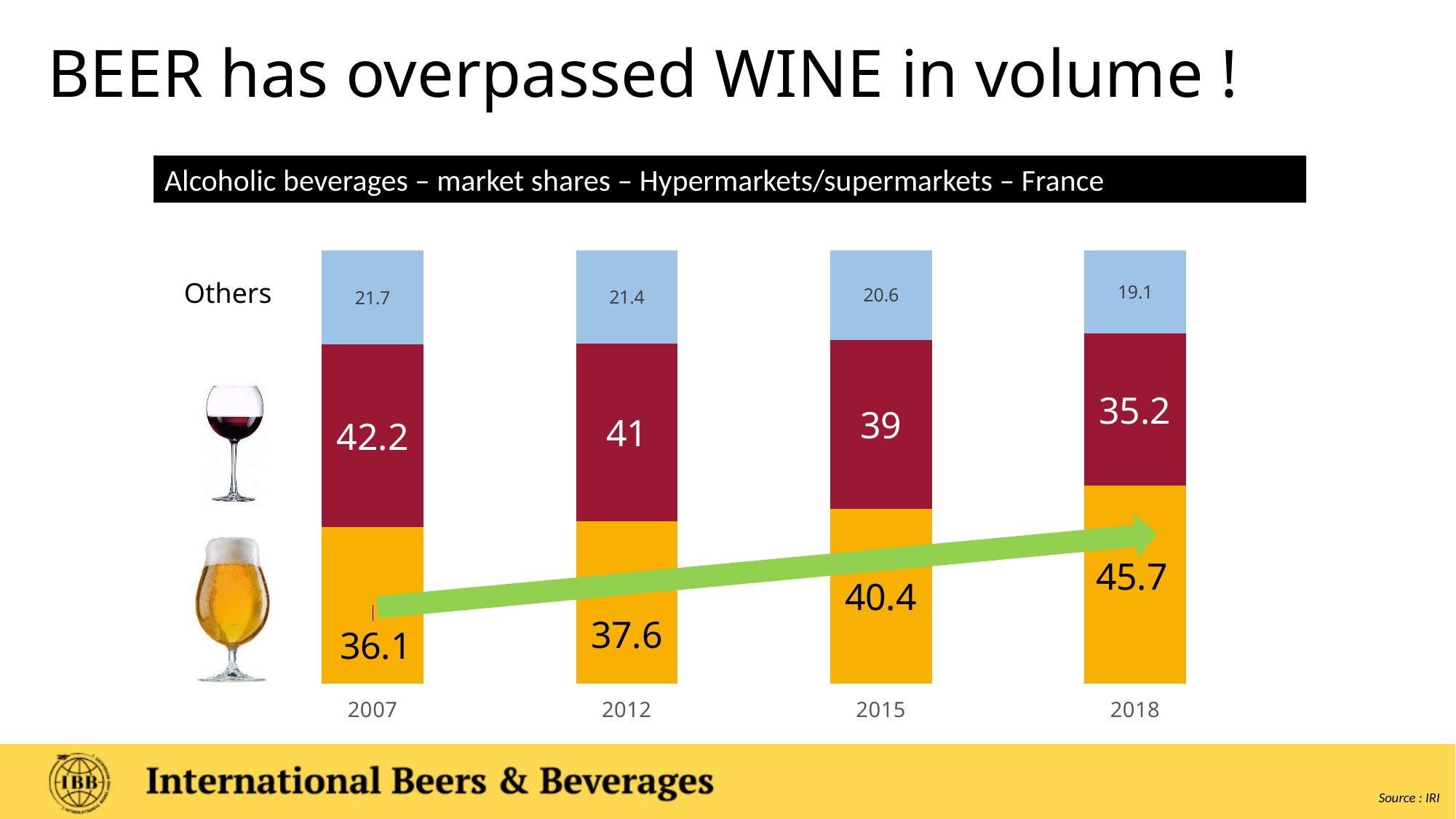
By how much did the beer (yellow segment) share increase from 2007 to 2018? 9.6 What is the total of the stacked bar for 2018? 100 What kind of chart is shown on the slide? Stacked bar chart In 2015, which is larger: the wine (red segment) share or the beer (yellow segment) share? Beer What is the difference between the wine (red segment) and beer (yellow segment) shares in 2012? 3.4 In which year is the Others segment lowest? 2018 Does the wine (red segment) share rise or fall from 2007 to 2018? Fall What is the beer (yellow segment) market share in 2007? 36.1 In which year is the beer (yellow segment) share highest? 2018 How many years are shown on the x axis of the chart? 4 What is the wine (red segment) market share in 2018? 35.2 What is the value of the Others segment in 2015? 20.6